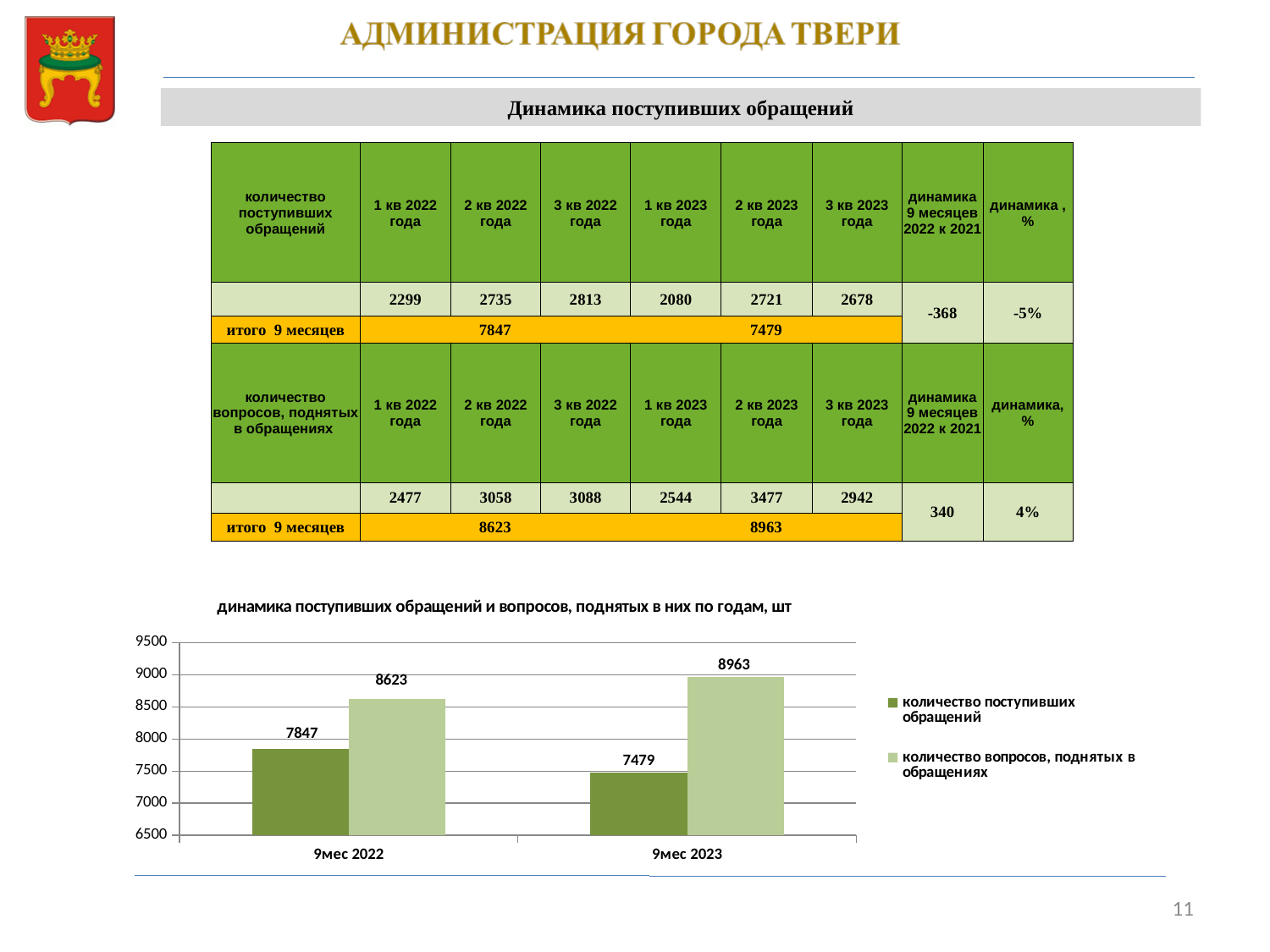
Which bar in the chart has the lowest value? количество поступивших обращений, 9мес 2023 How many categories are shown on the x axis of the chart? 2 What is the value for "количество поступивших обращений" for 9мес 2023? 7479 Which bar in the chart has the highest value? количество вопросов, поднятых в обращениях, 9мес 2023 What is the difference between "количество поступивших обращений" for 9мес 2022 and 9мес 2023? 368 What is the value for "количество поступивших обращений" for 9мес 2022? 7847 What type of chart is shown on the slide? bar chart Which is larger: "количество поступивших обращений" for 9мес 2022 or for 9мес 2023? 9мес 2022 What is the difference between "количество вопросов, поднятых в обращениях" for 9мес 2023 and 9мес 2022? 340 What is the value for "количество вопросов, поднятых в обращениях" for 9мес 2022? 8623 How many series does the chart legend list? 2 What is the value for "количество вопросов, поднятых в обращениях" for 9мес 2023? 8963